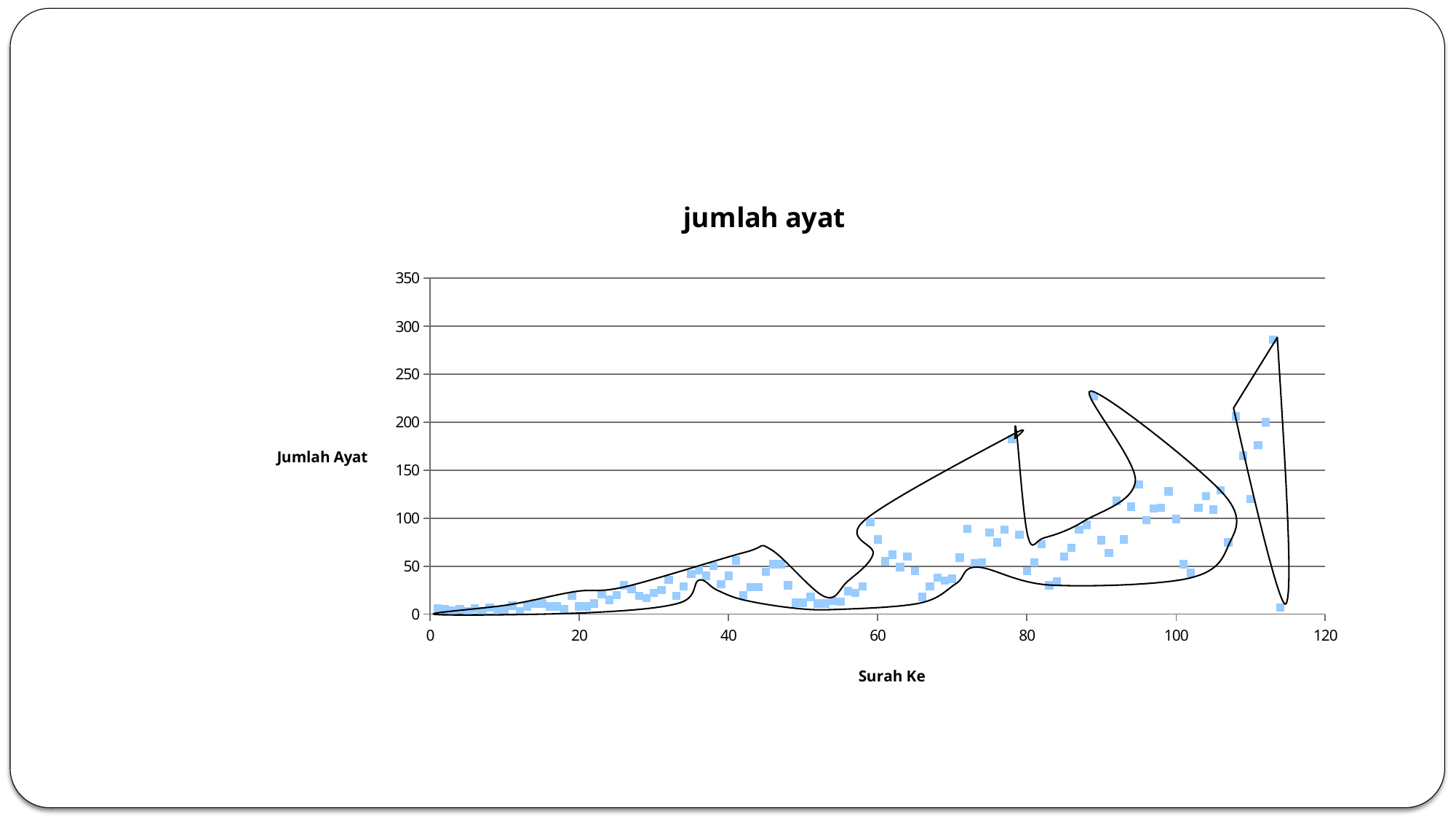
Is the highest plotted value on the chart greater or less than 250? greater What is the title of the chart? jumlah ayat What is the label on the horizontal axis of the chart? Surah Ke What kind of chart is shown on the slide? scatter chart Is the value of the point plotted at about Surah Ke 59 greater or less than 50? greater Overall, do the plotted values rise or fall as Surah Ke increases along the x axis? rise Is the highest plotted value on the chart greater or less than 300? less